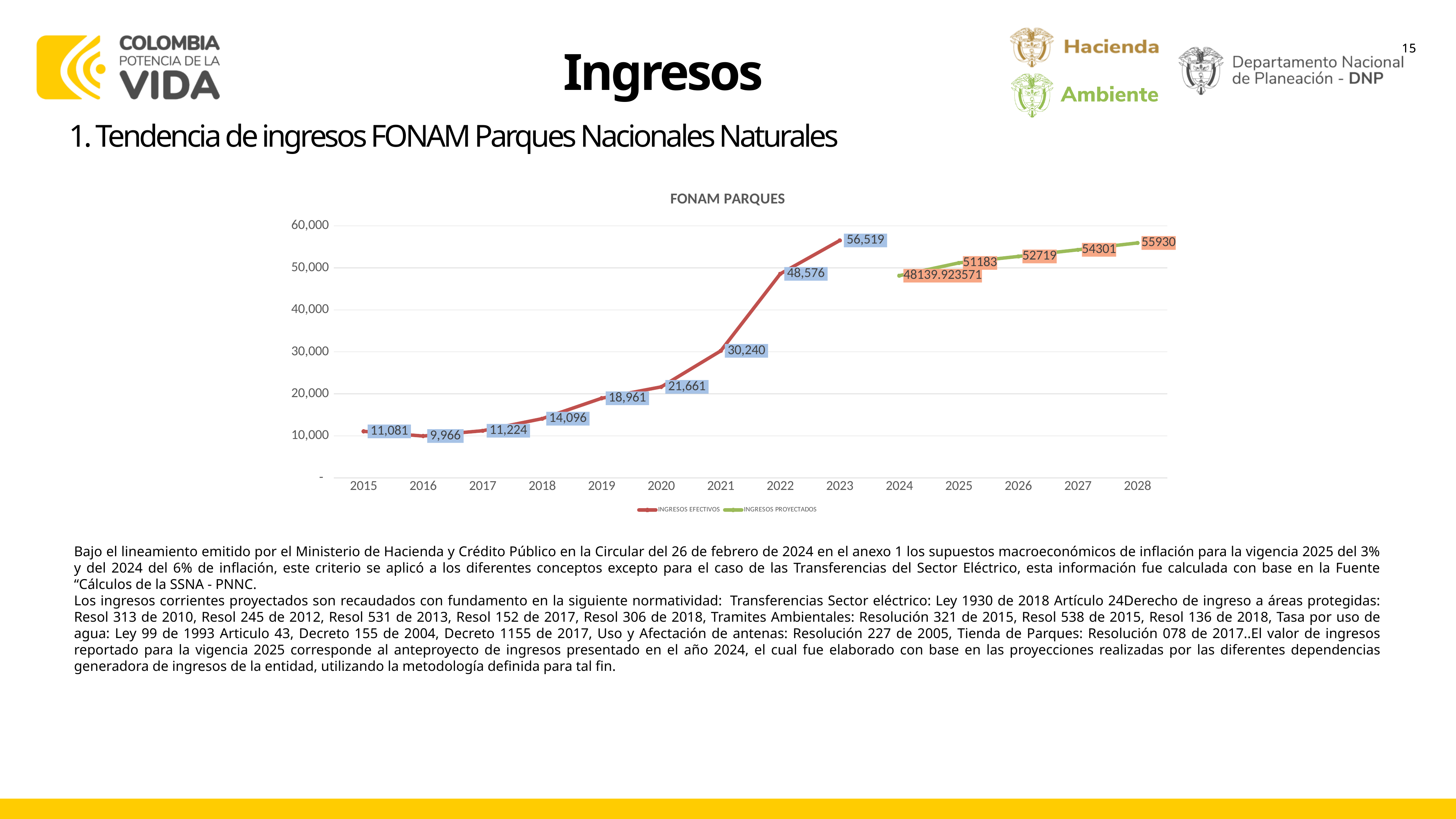
What is the value of INGRESOS PROYECTADOS for 2028? 55930 Which year has the highest value of INGRESOS EFECTIVOS? 2023 How many years are shown on the x axis? 14 Which year has the lowest value of INGRESOS EFECTIVOS? 2016 What is the difference between the INGRESOS EFECTIVOS values for 2022 and 2021? 18,336 Which is larger, the INGRESOS EFECTIVOS value for 2023 or the INGRESOS PROYECTADOS value for 2028? 2023 (56,519) What is the value of INGRESOS EFECTIVOS for 2016? 9,966 Do the INGRESOS PROYECTADOS values rise or fall from 2024 to 2028? Rise What is the value of INGRESOS EFECTIVOS for 2023? 56,519 What is the value of INGRESOS PROYECTADOS for 2025? 51183 How many series does the legend list? 2 What type of chart is shown under the title FONAM PARQUES? Line chart